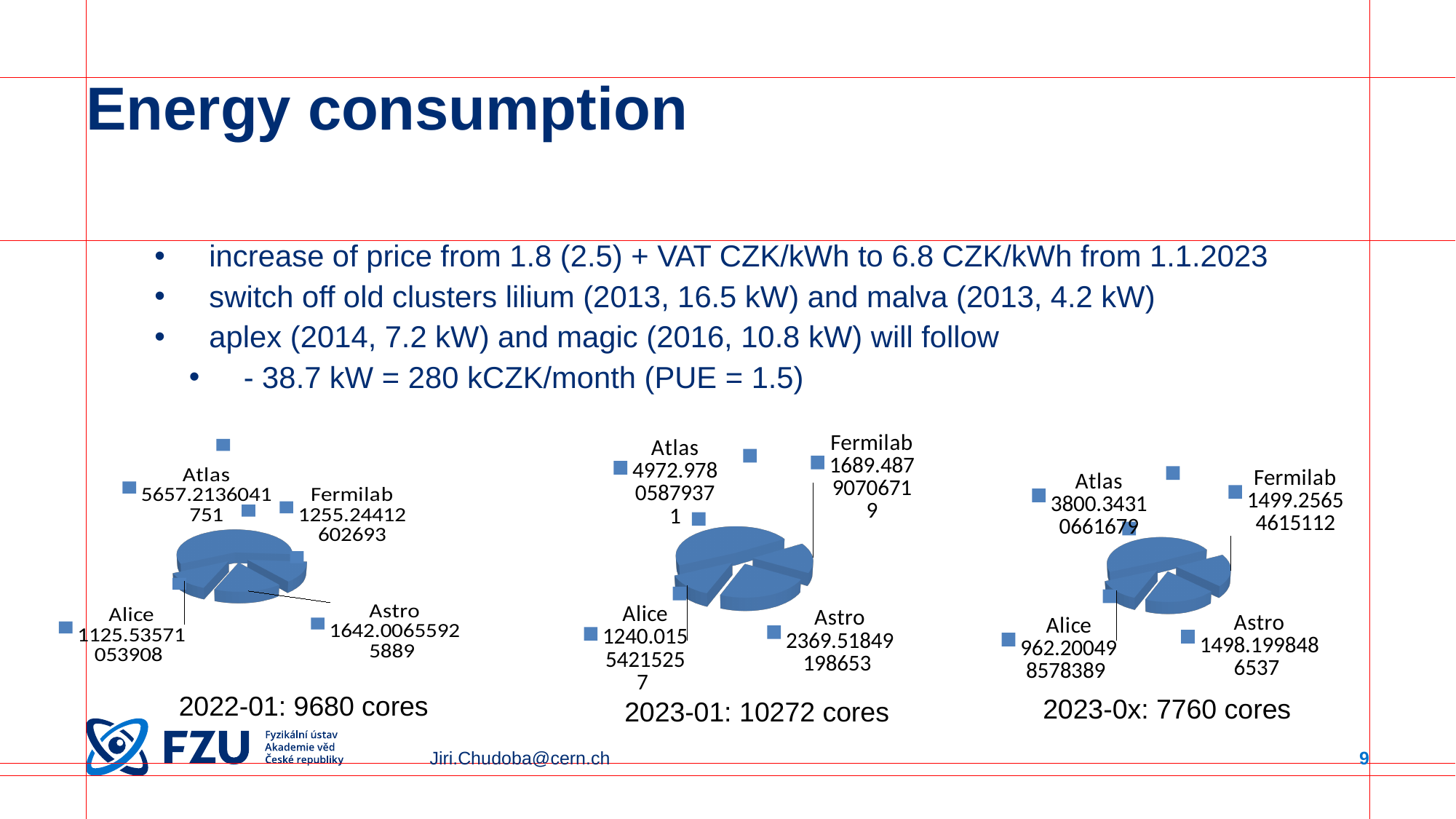
In the pie chart labelled 2023-01: 10272 cores, which is larger, Astro or Fermilab? Astro In the pie chart labelled 2022-01: 9680 cores, what is the value for Atlas? 5657.2136041751 In the pie chart labelled 2023-0x: 7760 cores, which labelled category has the lowest value? Alice In the pie chart labelled 2023-0x: 7760 cores, what is the value for Atlas? 3800.34310661679 In the pie chart labelled 2022-01: 9680 cores, which labelled category has the highest value? Atlas What type of chart is used for the three charts at the bottom of the slide? Pie chart In the pie chart labelled 2023-01: 10272 cores, what is the difference between the Astro and Fermilab values? 680.03058491934 In the pie chart labelled 2022-01: 9680 cores, what is the value for Astro? 1642.00655925889 In the pie chart labelled 2023-01: 10272 cores, what is the value for Astro? 2369.51849198653 In the pie chart labelled 2023-0x: 7760 cores, what is the value for Alice? 962.200498578389 In the pie chart labelled 2023-01: 10272 cores, what is the value for Fermilab? 1689.48790706719 In the pie chart labelled 2022-01: 9680 cores, which labelled category has the lowest value? Alice